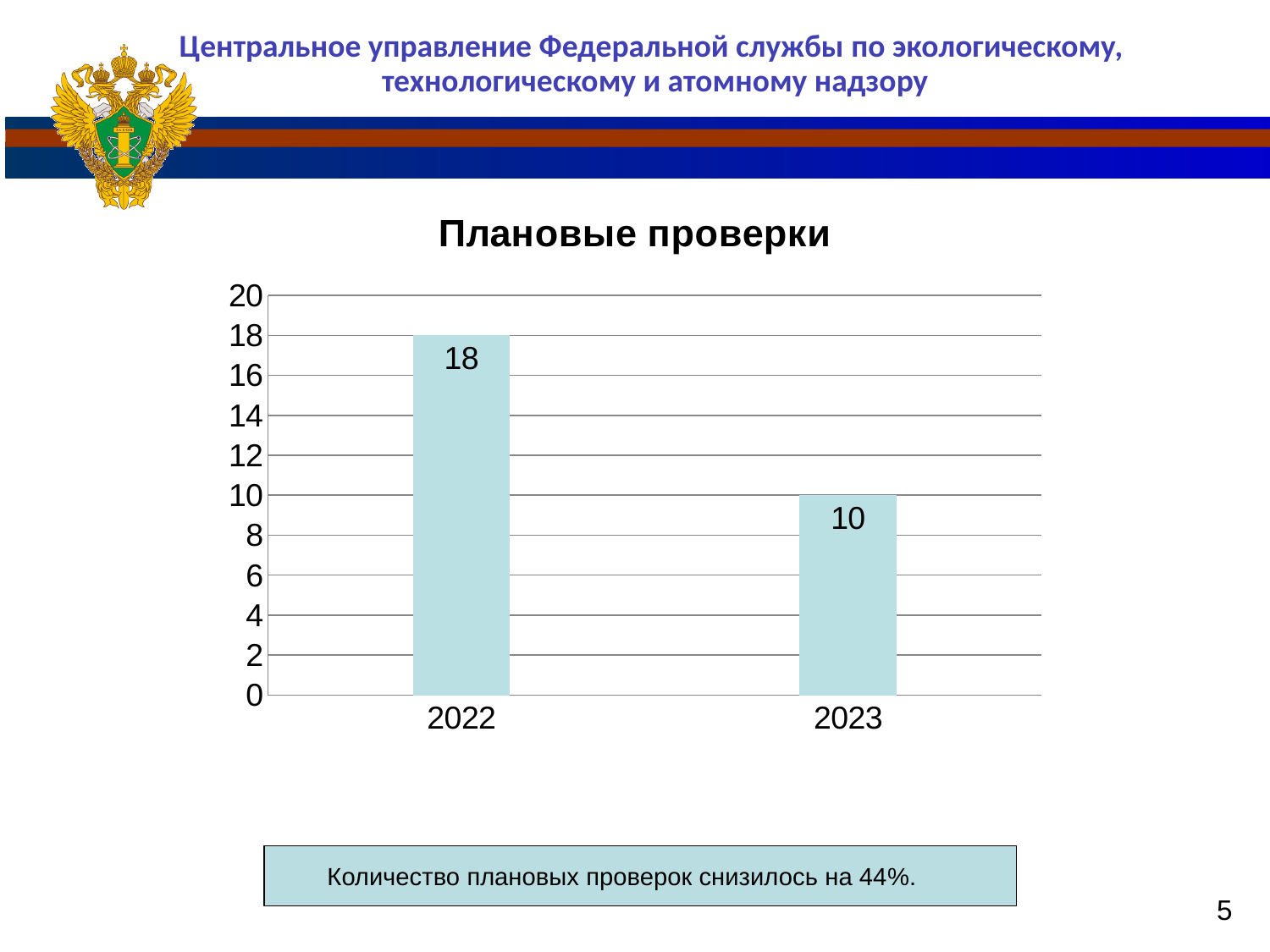
What is the difference between the values for 2022 and 2023? 8 What kind of chart is shown on the slide? bar chart Do the values rise or fall from 2022 to 2023? fall Is the value for 2023 greater or less than 12? less Which year has the highest value? 2022 What is the value for 2022? 18 Is the value for 2022 greater or less than 16? greater What is the title of the chart? Плановые проверки What is the value for 2023? 10 Which is larger, the value for 2022 or the value for 2023? 2022 Which year has the lowest value? 2023 How many categories are shown on the x axis? 2